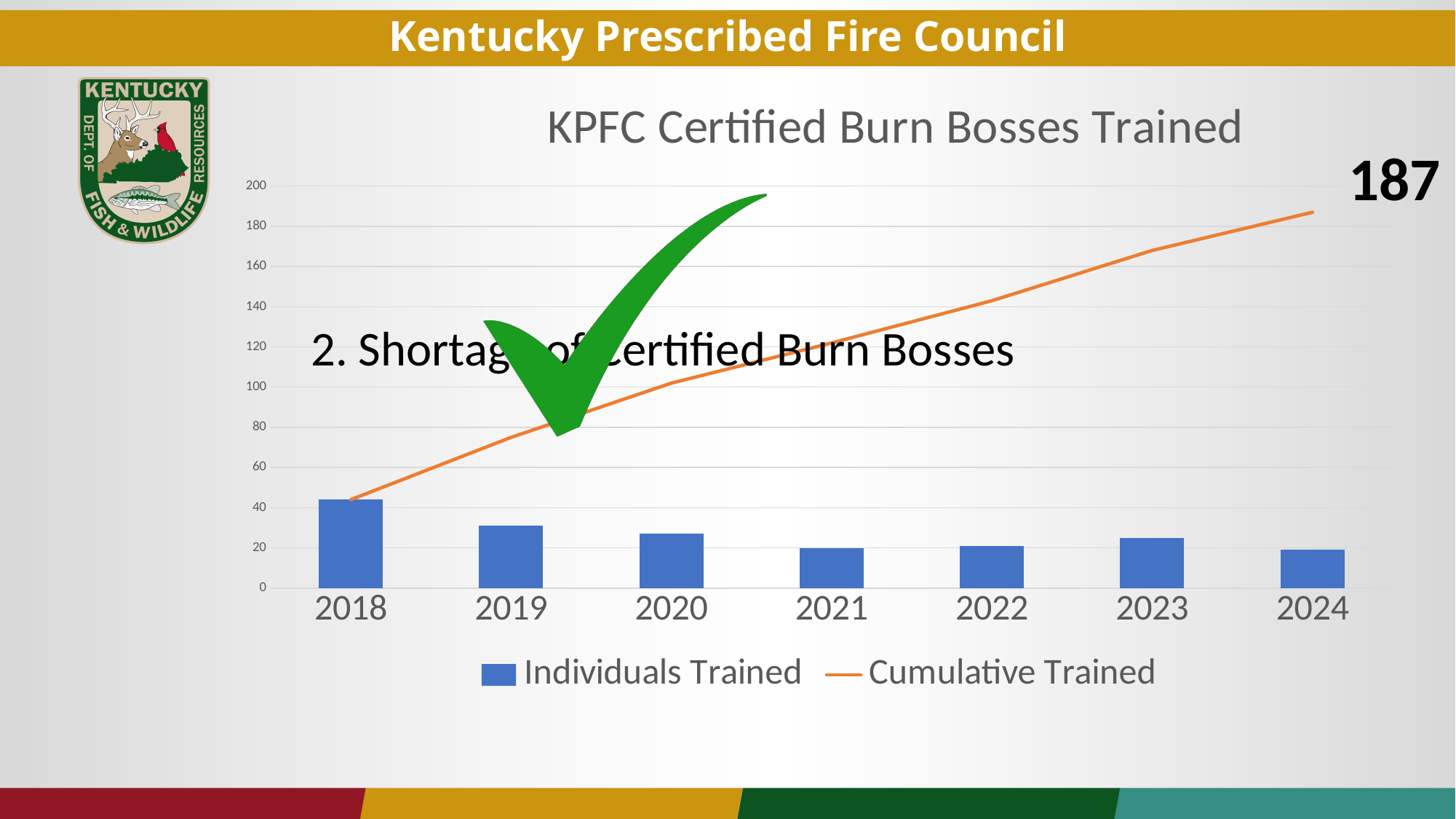
Is the value for Individuals Trained in 2023 greater or less than 20? greater What number is printed at the end of the Cumulative Trained line for 2024? 187 Which year has the highest number of Individuals Trained? 2018 Which series is shown as an orange line in the chart? Cumulative Trained What type of chart is shown on the slide? A combination bar and line chart Is the value for Individuals Trained in 2021 greater or less than 40? less How many years are shown on the x axis of the chart? 7 Does the Cumulative Trained line rise or fall from 2018 to 2024? rise Which year has more Individuals Trained, 2019 or 2020? 2019 How many series does the chart legend list? 2 What is the title of the chart? KPFC Certified Burn Bosses Trained Is the value for Individuals Trained in 2018 greater or less than 40? greater